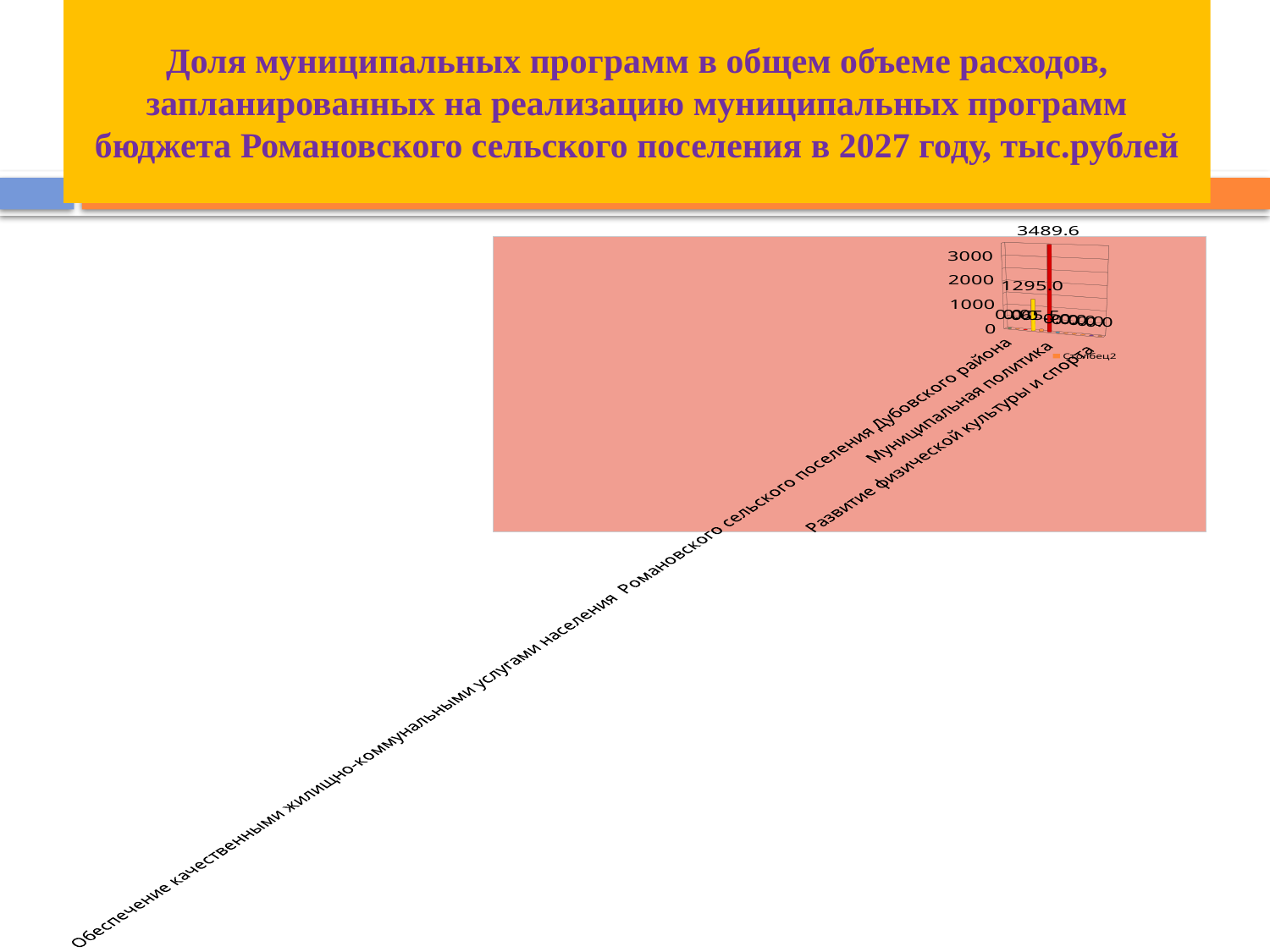
What is the difference between the two largest labelled values, 3489.6 and 1295.0? 2194.6 What is the largest value labelled on the chart? 3489.6 What is the second-largest value labelled on the chart? 1295.0 Is the value of the yellow bar greater or less than 2000? less In what units are the values on the chart expressed, according to the slide title? тыс.рублей What kind of chart is shown on the slide? bar chart How many series does the legend list? 1 Is the value of the tallest bar greater or less than 3000? greater What is the name of the series shown in the legend? Столбец2 Which is larger, the value of the red bar (3489.6) or the value of the yellow bar (1295.0)? 3489.6